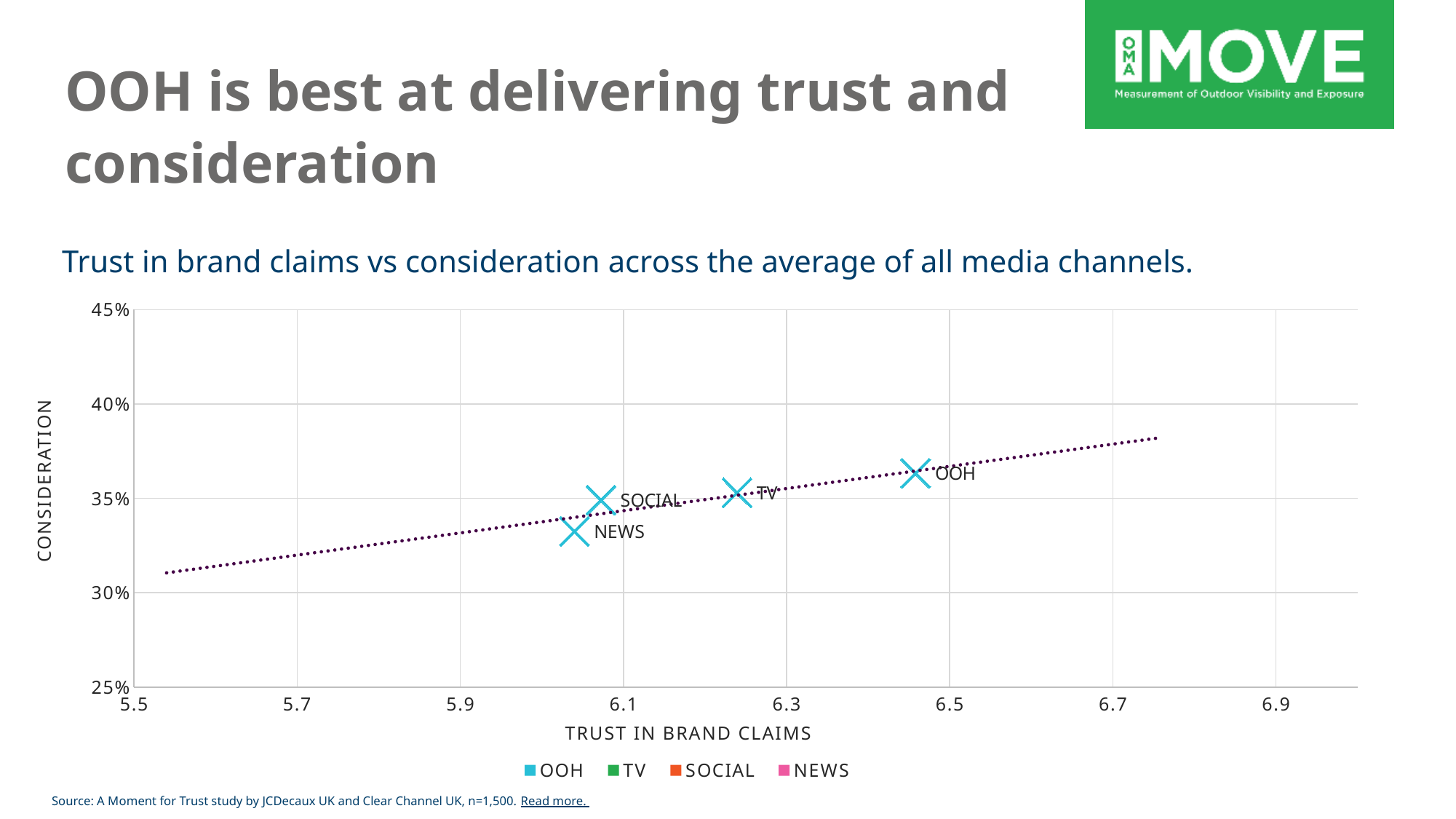
What kind of chart is shown on the slide? scatter chart What is the label of the x axis? TRUST IN BRAND CLAIMS Does the dotted trend line rise or fall as trust in brand claims increases? rises Is the consideration value for NEWS greater or less than 35%? less Which media channel has the lowest consideration? NEWS Which media channel has the highest consideration? OOH Is the trust in brand claims value for OOH greater or less than 6.3? greater How many media channels are plotted as points on the chart? 4 Which media channel has the highest trust in brand claims? OOH Is the consideration value for OOH greater or less than 35%? greater How many series does the legend list? 4 Which has higher trust in brand claims, OOH or TV? OOH